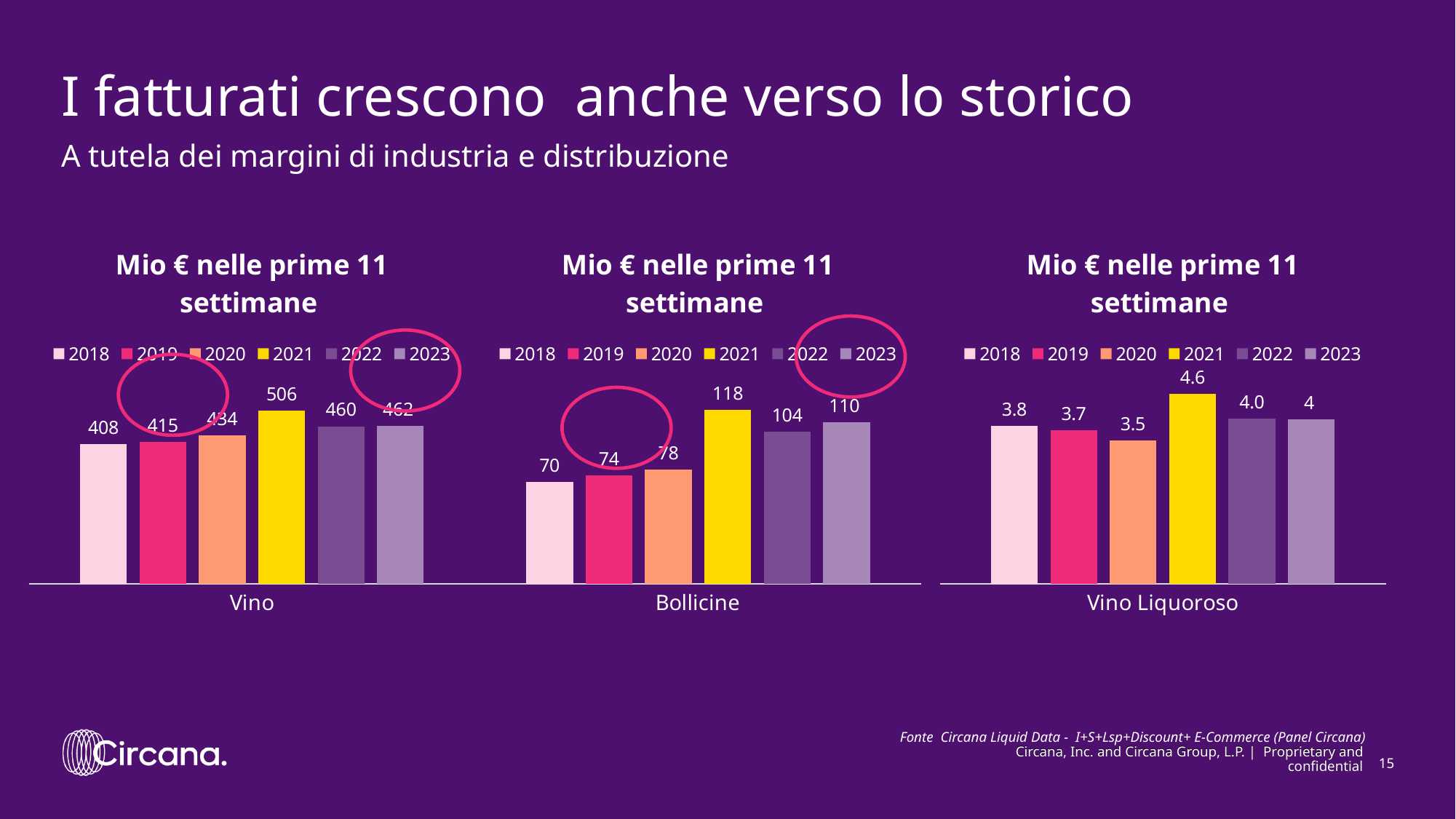
In the middle chart (Bollicine), what is the difference between the 2021 value and the 2018 value? 48 In the left chart (Vino), what is the value for 2021? 506 How many series does the legend of the left chart (Vino) list? 6 What type of chart is the right chart (Vino Liquoroso)? Bar chart In the right chart (Vino Liquoroso), what is the value for 2021? 4.6 In the right chart (Vino Liquoroso), which year has the lowest value? 2020 In the left chart (Vino), what is the value for 2018? 408 In the left chart (Vino), what is the difference between the 2021 value and the 2022 value? 46 In the middle chart (Bollicine), what is the value for 2023? 110 In the middle chart (Bollicine), which is larger, the value for 2022 or the value for 2023? 2023 In the middle chart (Bollicine), which year has the highest value? 2021 In the middle chart (Bollicine), which year has the lowest value? 2018